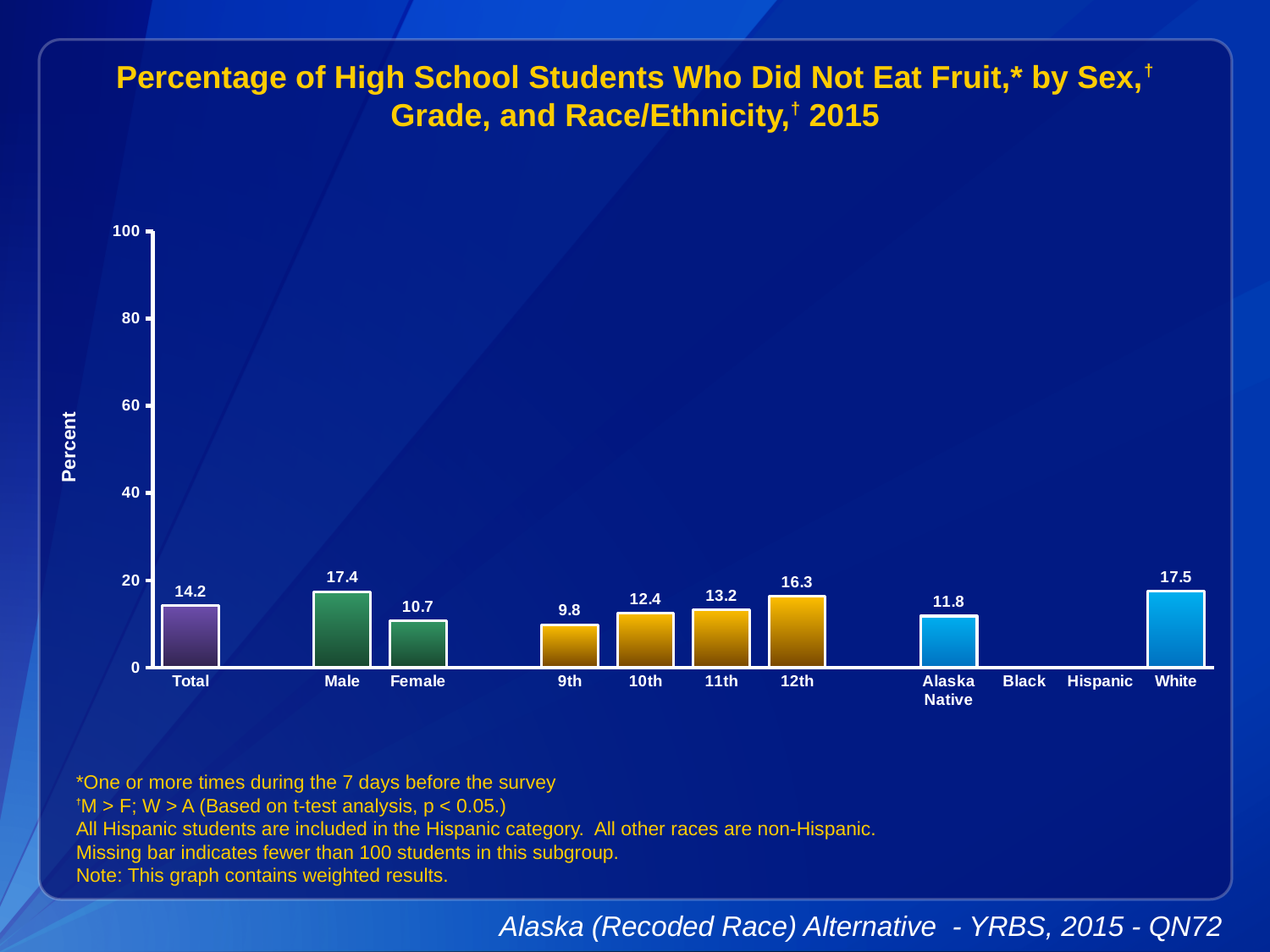
What is the value for Alaska Native students? 11.8 Which is larger, the value for 11th grade or the value for 10th grade? 11th Which category has the lowest value? 9th How many categories are labeled on the x axis? 11 What is the value for Total? 14.2 What kind of chart is shown? bar chart Is the value for Total greater or less than 20? less What percentage of male students did not eat fruit? 17.4 What is the difference between the Male and Female values? 6.7 What is the difference between the 12th grade and 9th grade values? 6.5 Do the values rise or fall from 9th grade to 12th grade? rise What is the value for 12th grade? 16.3